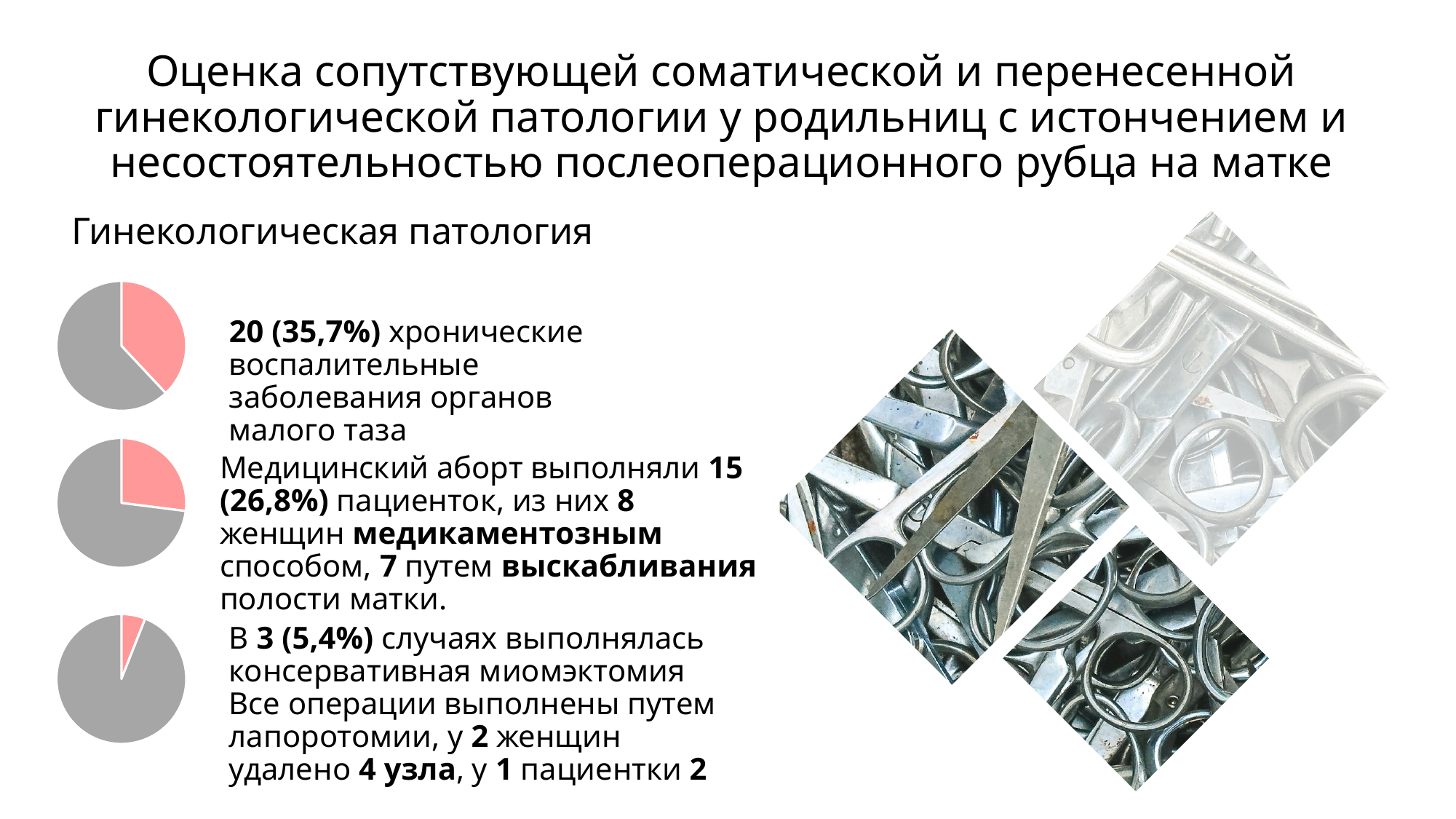
How many patients does the pink slice of the middle pie chart (medical abortion) correspond to? 15 How many patients does the pink slice of the top pie chart (chronic inflammatory diseases) correspond to? 20 How many pie charts are on the slide? 3 In the top pie chart (chronic inflammatory diseases of the pelvic organs), what share does the pink slice represent? 35,7% What kind of charts are shown on the left side of the slide? Pie charts What colour is used for the highlighted slice in each pie chart? Pink Which of the three pie charts has the largest pink slice? The top one (chronic inflammatory diseases of the pelvic organs) How many cases does the pink slice of the bottom pie chart (conservative myomectomy) correspond to? 3 Which of the three pie charts has the smallest pink slice? The bottom one (conservative myomectomy) Is the pink slice larger in the top pie chart (chronic inflammatory diseases) or in the middle pie chart (medical abortion)? Top pie chart (chronic inflammatory diseases) In the middle pie chart (medical abortion), what share does the pink slice represent? 26,8% In the bottom pie chart (conservative myomectomy), what share does the pink slice represent? 5,4%